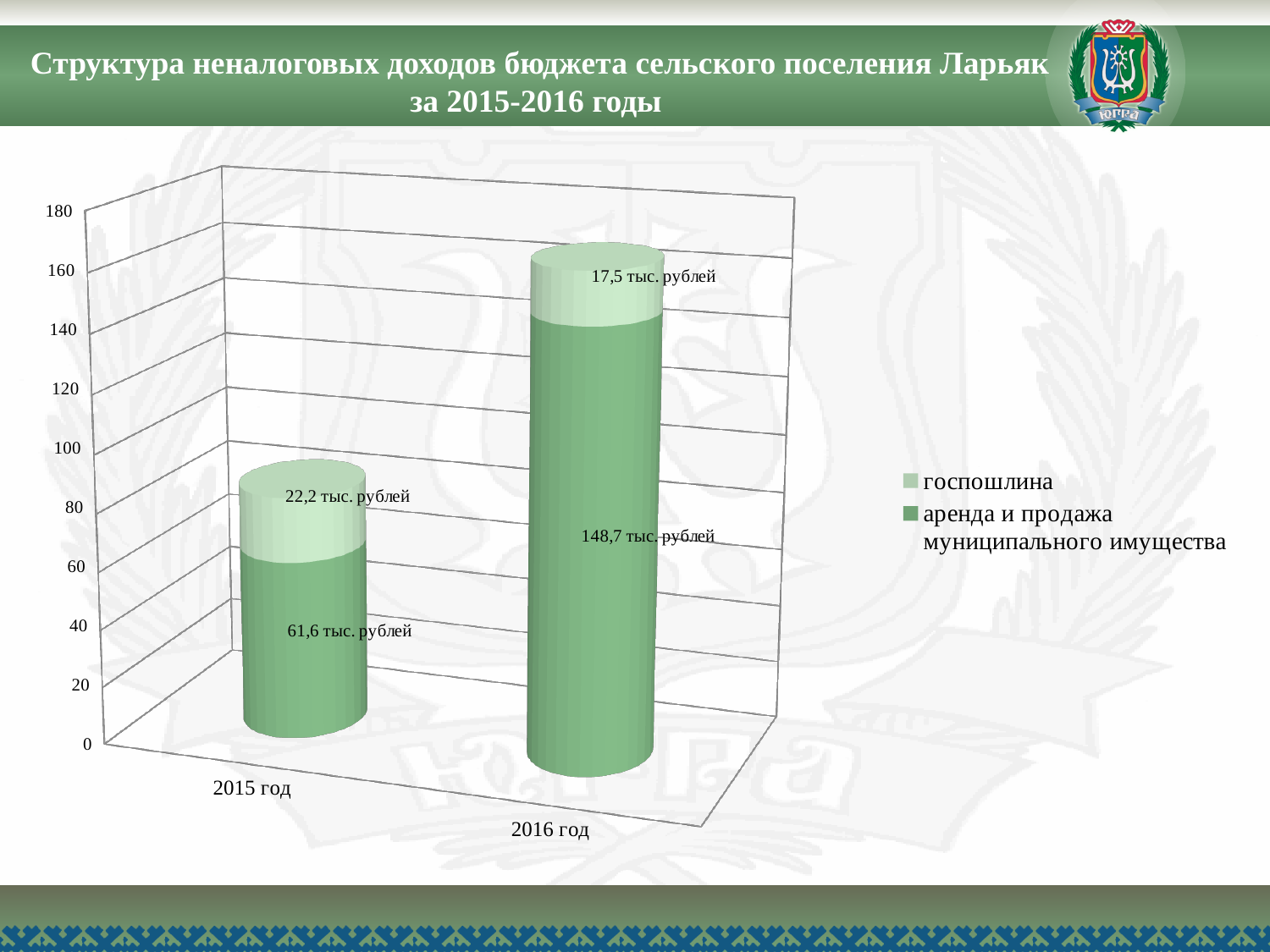
How many series does the legend list? 2 What kind of chart is shown on the slide? Stacked bar chart In which year is аренда и продажа муниципального имущества highest? 2016 год What is the difference between аренда и продажа муниципального имущества in 2016 год and in 2015 год? 87,1 тыс. рублей What is the total of the stacked bar for 2016 год? 166,2 тыс. рублей What is the total of the stacked bar for 2015 год? 83,8 тыс. рублей What is the value of госпошлина for 2016 год? 17,5 тыс. рублей What is the value of аренда и продажа муниципального имущества for 2015 год? 61,6 тыс. рублей What is the value of госпошлина for 2015 год? 22,2 тыс. рублей In which year is госпошлина lowest? 2016 год What is the value of аренда и продажа муниципального имущества for 2016 год? 148,7 тыс. рублей Which is larger: госпошлина in 2015 год or госпошлина in 2016 год? 2015 год